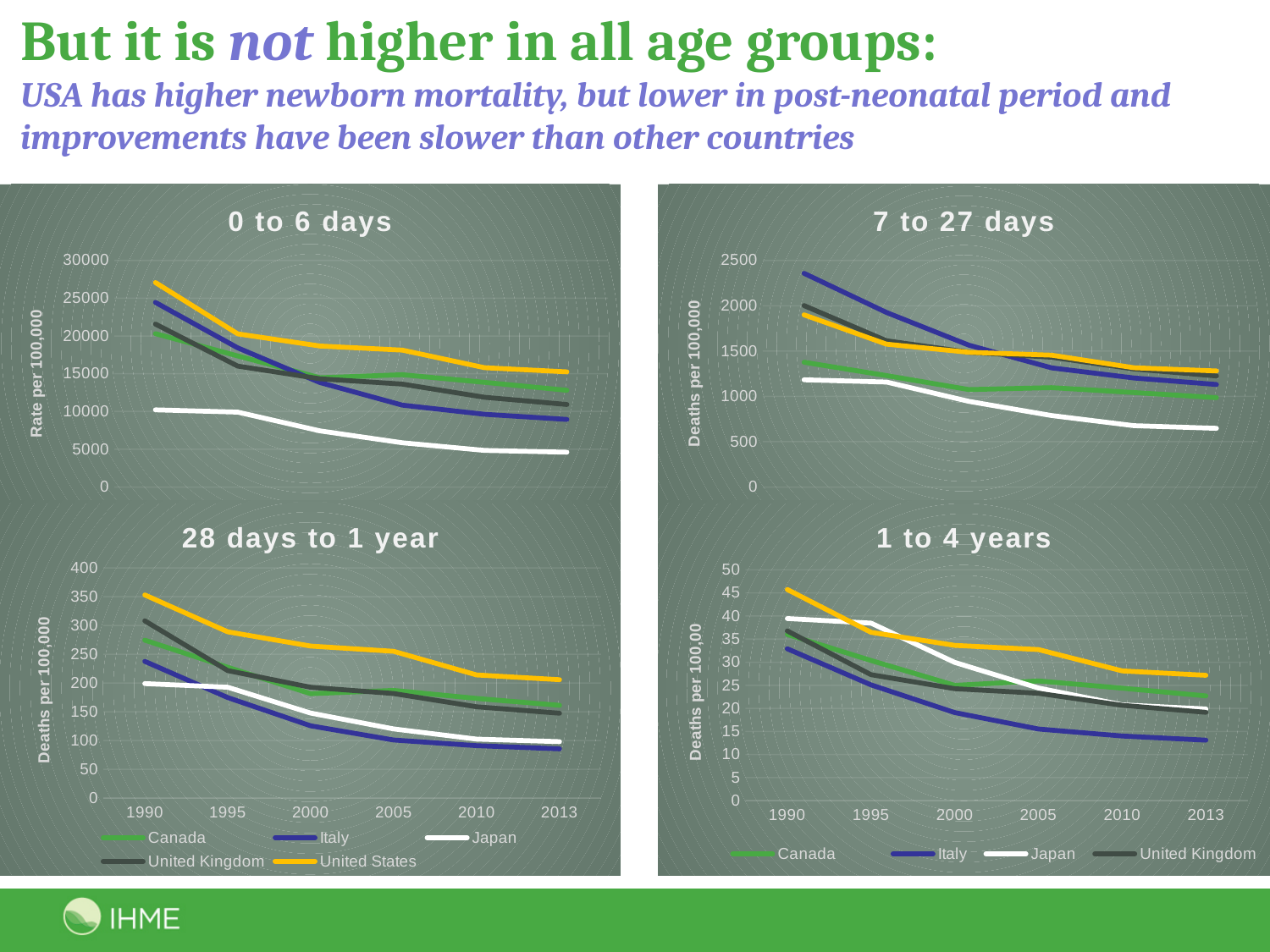
What kind of chart is the "0 to 6 days" chart? line chart In the "7 to 27 days" chart, which country has the highest value in 1990? Italy How many years are shown on the x axis of the "1 to 4 years" chart? 6 In the "7 to 27 days" chart, is the value for Japan in 2013 greater or less than 1000? less In the "7 to 27 days" chart, does the value for Italy rise or fall from 1990 to 2013? fall In the "28 days to 1 year" chart, which country has the highest value in 2013? United States How many series does the legend of the "28 days to 1 year" chart list? 5 In the "0 to 6 days" chart, which country has the lowest rate in 2013? Japan In the "0 to 6 days" chart, is the value for United States in 1990 greater or less than 25000? greater In the "1 to 4 years" chart, which country has the lowest value in 2013? Italy In the "28 days to 1 year" chart, is the value for United States in 1990 greater or less than 300? greater In the "0 to 6 days" chart, which is larger in 2013, United States or Japan? United States